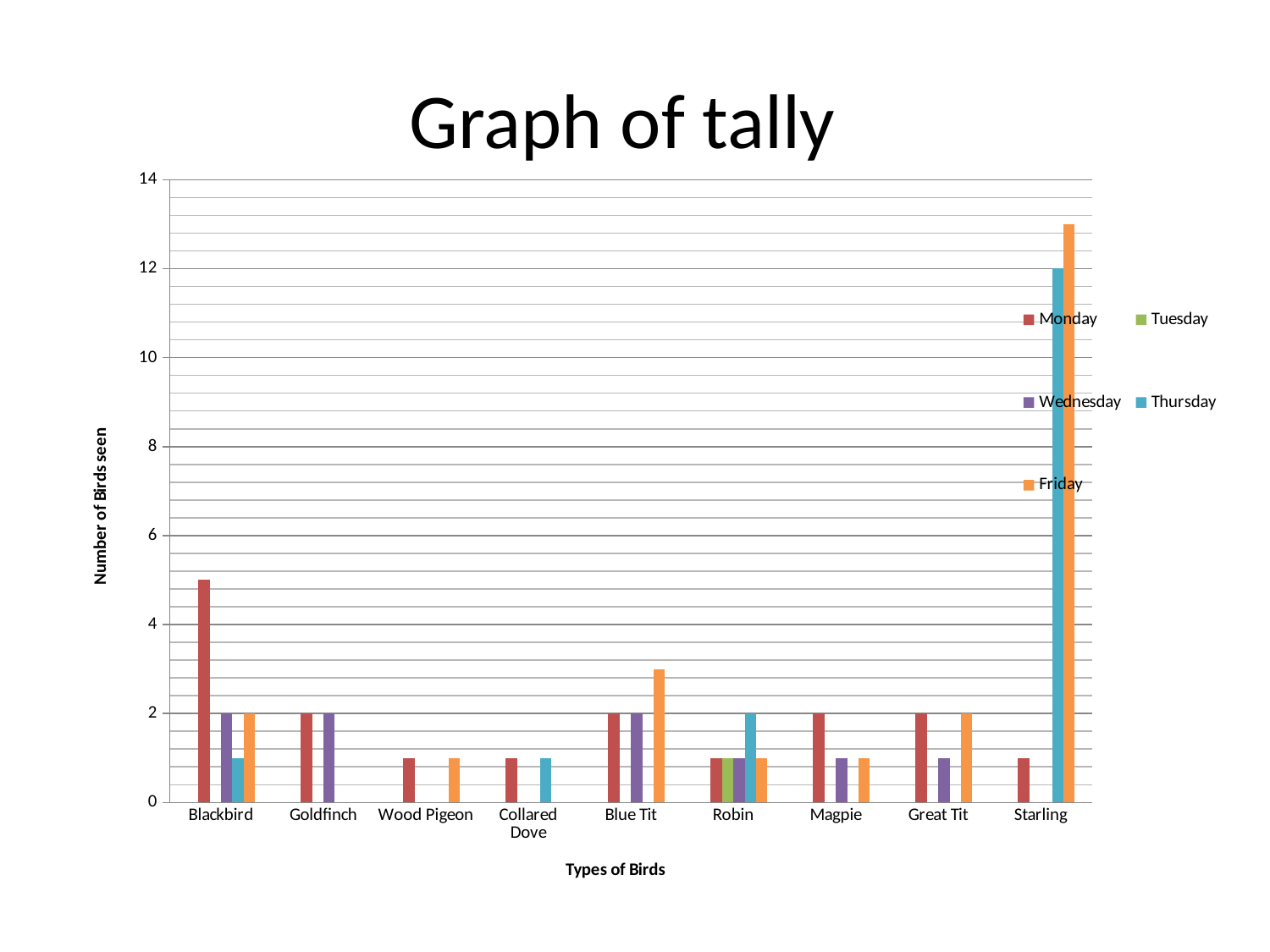
What is the value for Starling on Thursday? 12 What is the title of the chart? Graph of tally Is the value for Starling on Friday greater or less than 10? greater Is the value for Blackbird on Monday greater or less than 4? greater Which type of bird has the highest value on Monday? Blackbird Which is larger on Monday: the value for Blackbird or the value for Goldfinch? Blackbird How many series does the legend list? 5 What is the value for Robin on Thursday? 2 What kind of chart is shown on the slide? bar chart How many types of birds are shown on the x axis? 9 Which type of bird has the highest value on Friday? Starling For Blue Tit, which is larger: the Friday value or the Monday value? Friday